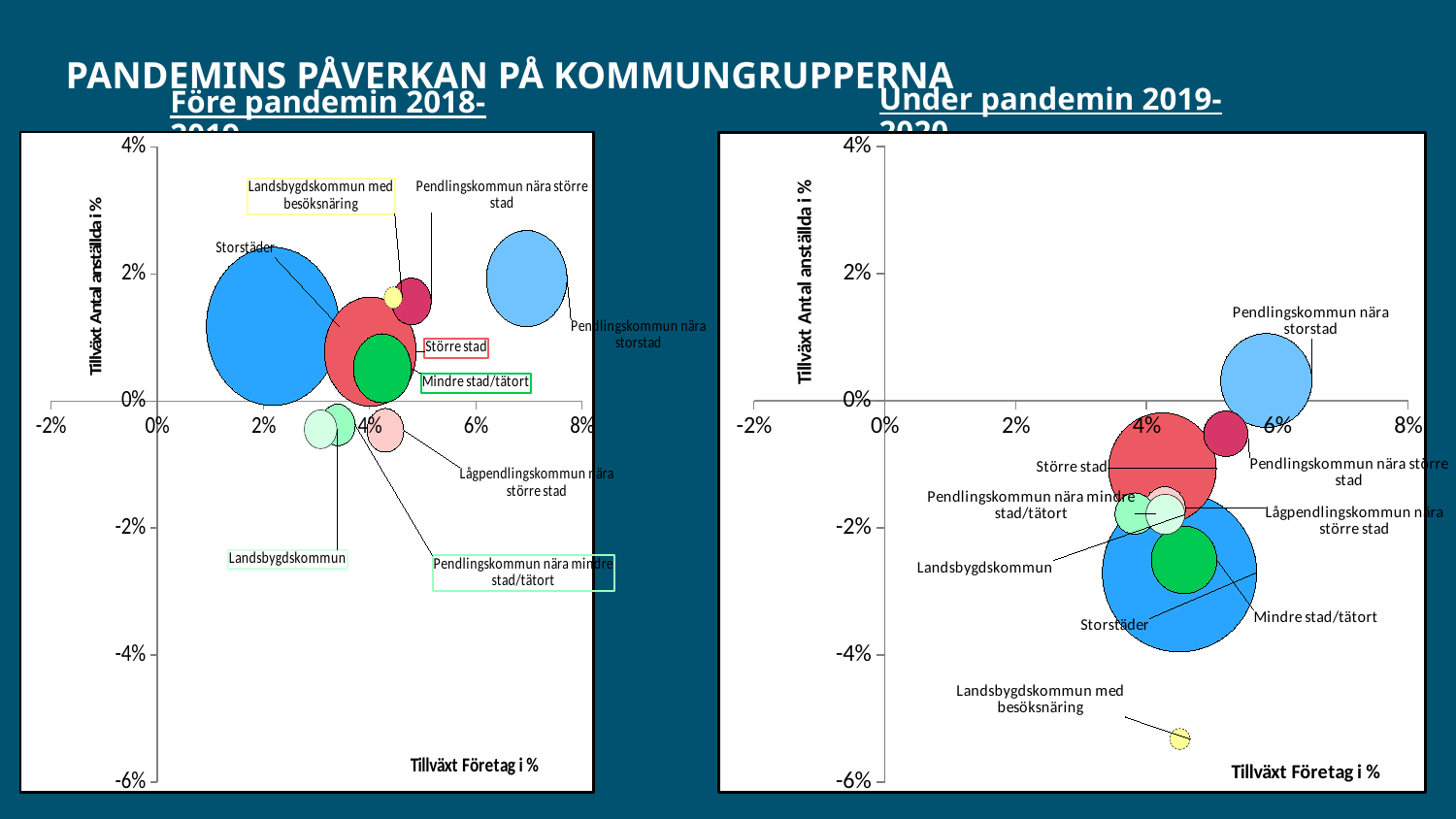
In the right chart (Under pandemin 2019-2020), is the employee growth (y-axis) for Storstäder greater or less than -2%? less In the right chart (Under pandemin 2019-2020), how many municipality groups (bubbles) are plotted? 9 In the right chart (Under pandemin 2019-2020), which municipality group has the highest growth in number of employees? Pendlingskommun nära storstad In the left chart (Före pandemin 2018-2019), is the company growth (x-axis) for Pendlingskommun nära storstad greater or less than 6%? greater In the right chart (Under pandemin 2019-2020), which municipality group has the lowest growth in number of employees? Landsbygdskommun med besöksnäring In the left chart (Före pandemin 2018-2019), is the employee growth (y-axis) for Storstäder greater or less than 0%? greater What is the label of the vertical axis in both charts? Tillväxt Antal anställda i % What kind of chart is shown on the left side of the slide (Före pandemin)? bubble chart In the right chart (Under pandemin 2019-2020), which has the higher employee growth: Pendlingskommun nära storstad or Storstäder? Pendlingskommun nära storstad In the left chart (Före pandemin 2018-2019), how many municipality groups (bubbles) are plotted? 9